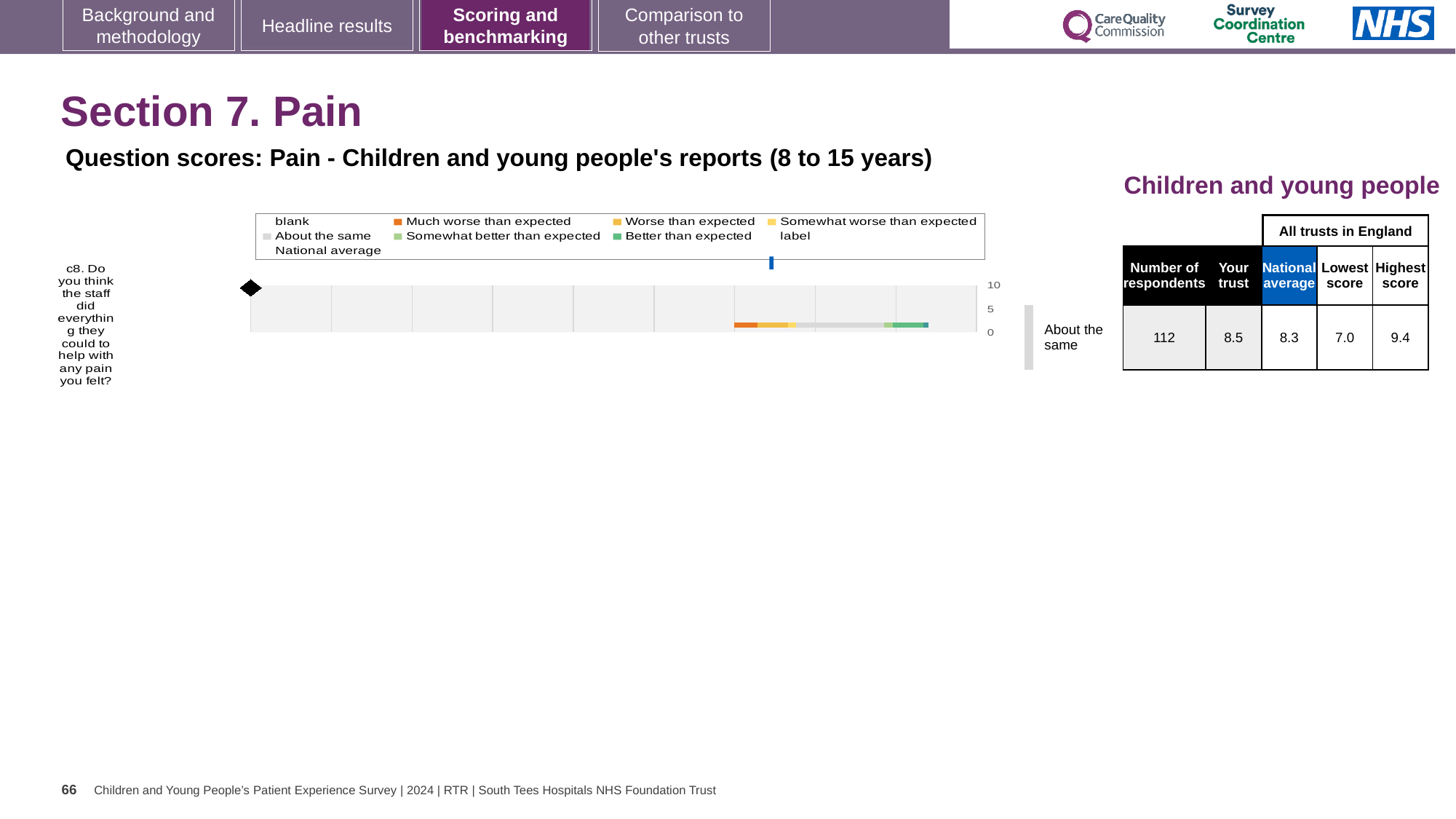
How many survey questions are plotted in the chart? 1 For question c8, what is the difference between the highest score and the lowest score among all trusts in England? 2.4 What is the highest score among all trusts in England for question c8? 9.4 How many respondents answered question c8? 112 What is the national average score for question c8? 8.3 What benchmark category is shown for question c8 next to the chart? About the same What is the 'Your trust' score for question c8? 8.5 For question c8, which is larger: the 'Your trust' score or the national average? Your trust What kind of chart is shown on the slide? bar chart How many entries does the chart legend list? 9 What is the lowest score among all trusts in England for question c8? 7.0 Which survey question is plotted in the chart? c8. Do you think the staff did everything they could to help with any pain you felt?